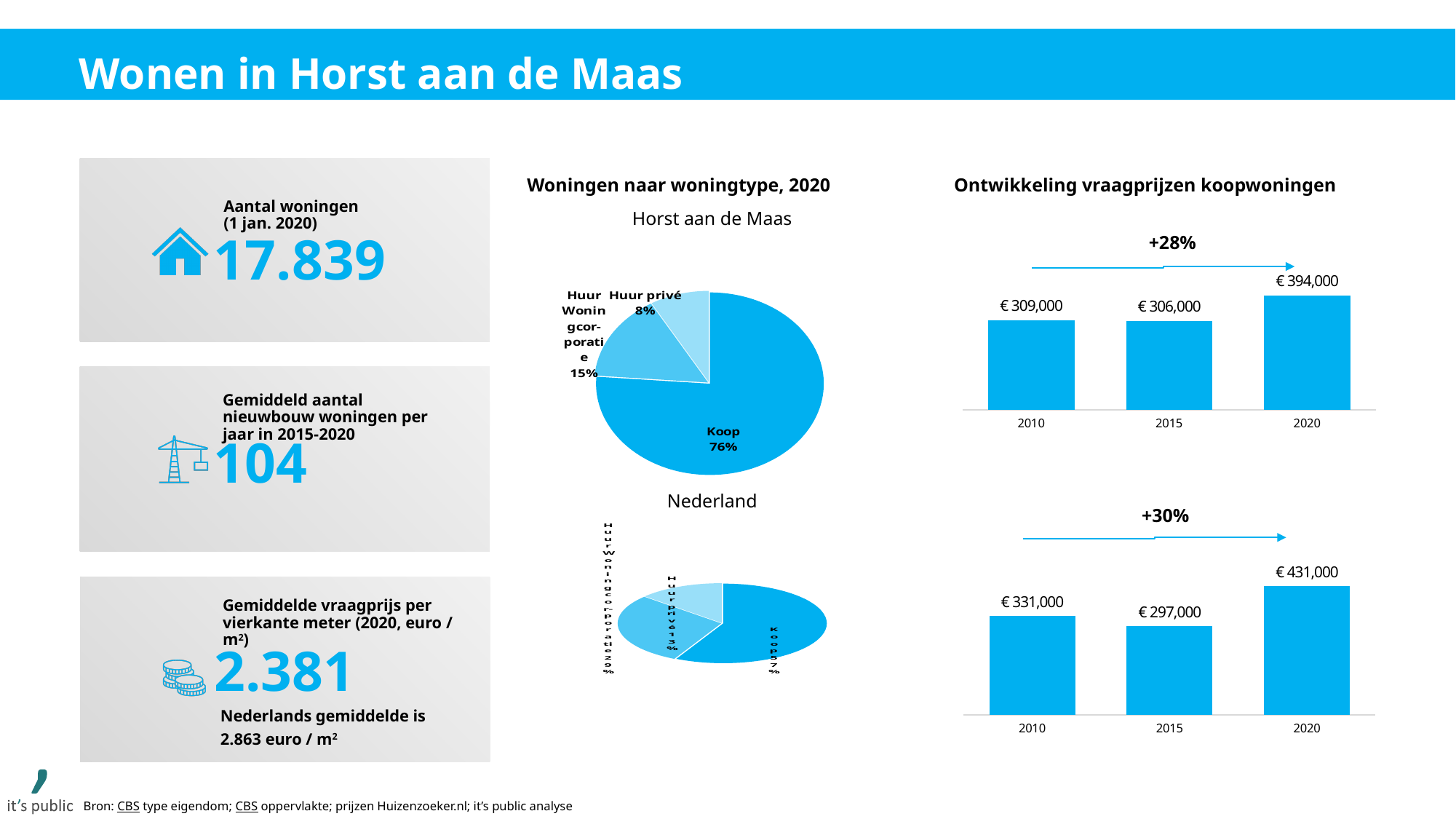
In the lower bar chart under 'Ontwikkeling vraagprijzen koopwoningen', what is the difference between the 2020 and 2010 values? € 100,000 How many bars are in the lower bar chart under 'Ontwikkeling vraagprijzen koopwoningen'? 3 In the upper bar chart under 'Ontwikkeling vraagprijzen koopwoningen', what is the value for 2020? € 394,000 In the 'Horst aan de Maas' pie chart, which slice is the smallest? Huur privé In the upper bar chart under 'Ontwikkeling vraagprijzen koopwoningen', what is the value for 2015? € 306,000 What percentage change is shown above the lower bar chart under 'Ontwikkeling vraagprijzen koopwoningen'? +30% In the lower bar chart under 'Ontwikkeling vraagprijzen koopwoningen', which year has the lowest value? 2015 In the upper bar chart under 'Ontwikkeling vraagprijzen koopwoningen', is the value for 2010 larger or smaller than the value for 2015? larger In the 'Horst aan de Maas' pie chart, what share does 'Huur privé' have? 8% In the 'Horst aan de Maas' pie chart, what share does 'Koop' have? 76% In the upper bar chart under 'Ontwikkeling vraagprijzen koopwoningen', which year has the highest value? 2020 In the lower bar chart under 'Ontwikkeling vraagprijzen koopwoningen', what is the value for 2010? € 331,000